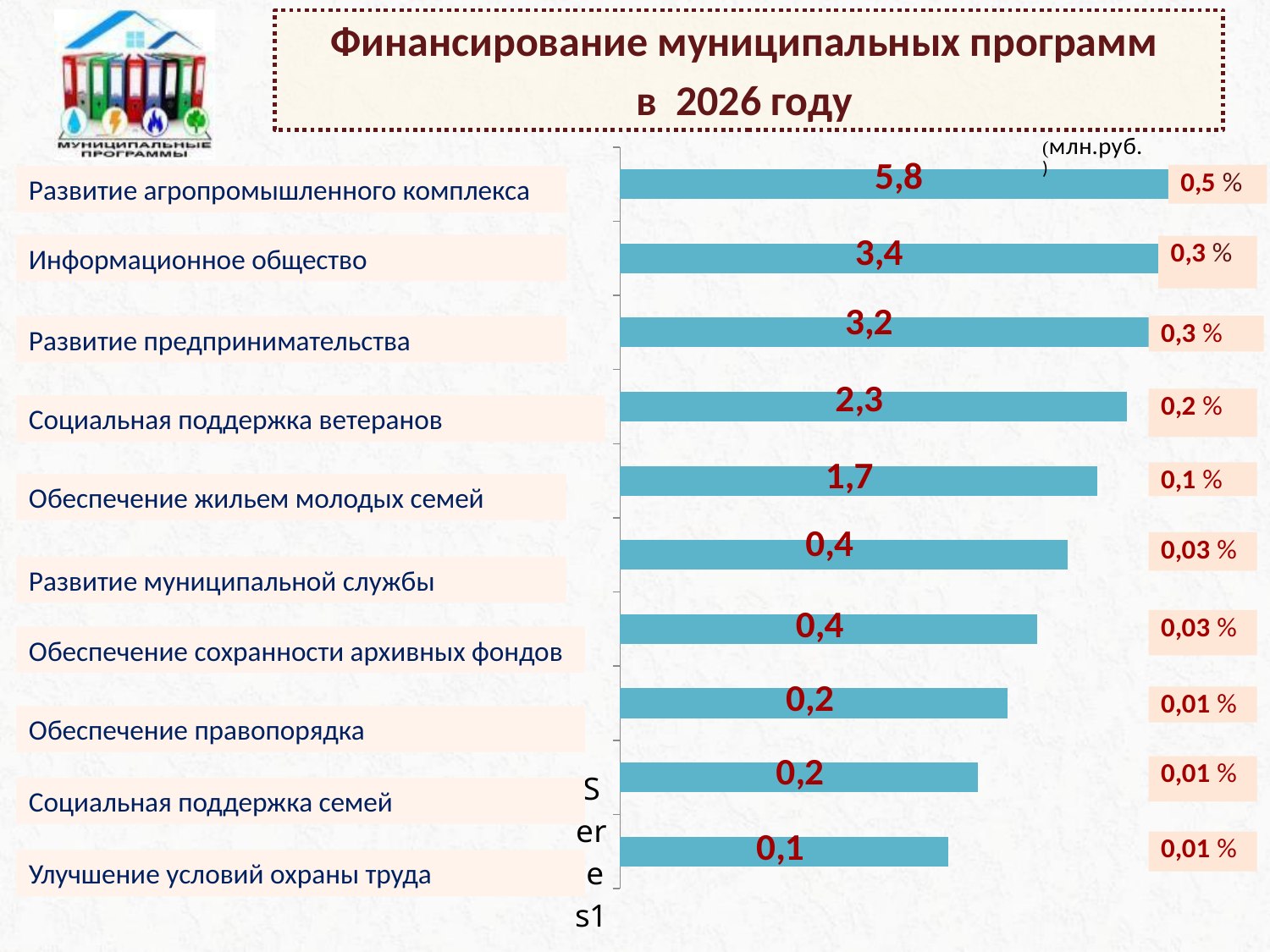
Do the values rise or fall going from the top bar to the bottom bar? Fall Which program has the lowest value? Улучшение условий охраны труда Which program has the highest value? Развитие агропромышленного комплекса What is the difference between the values for Развитие агропромышленного комплекса and Информационное общество? 2,4 Which is larger: the value for Информационное общество or for Развитие предпринимательства? Информационное общество What is the value for Развитие агропромышленного комплекса? 5,8 What is the value for Социальная поддержка ветеранов? 2,3 What is the value for Улучшение условий охраны труда? 0,1 What kind of chart is shown on the slide? Bar chart What is the value for Обеспечение жильем молодых семей? 1,7 How many programs are shown in the chart? 10 What unit is indicated for the chart values? млн.руб.